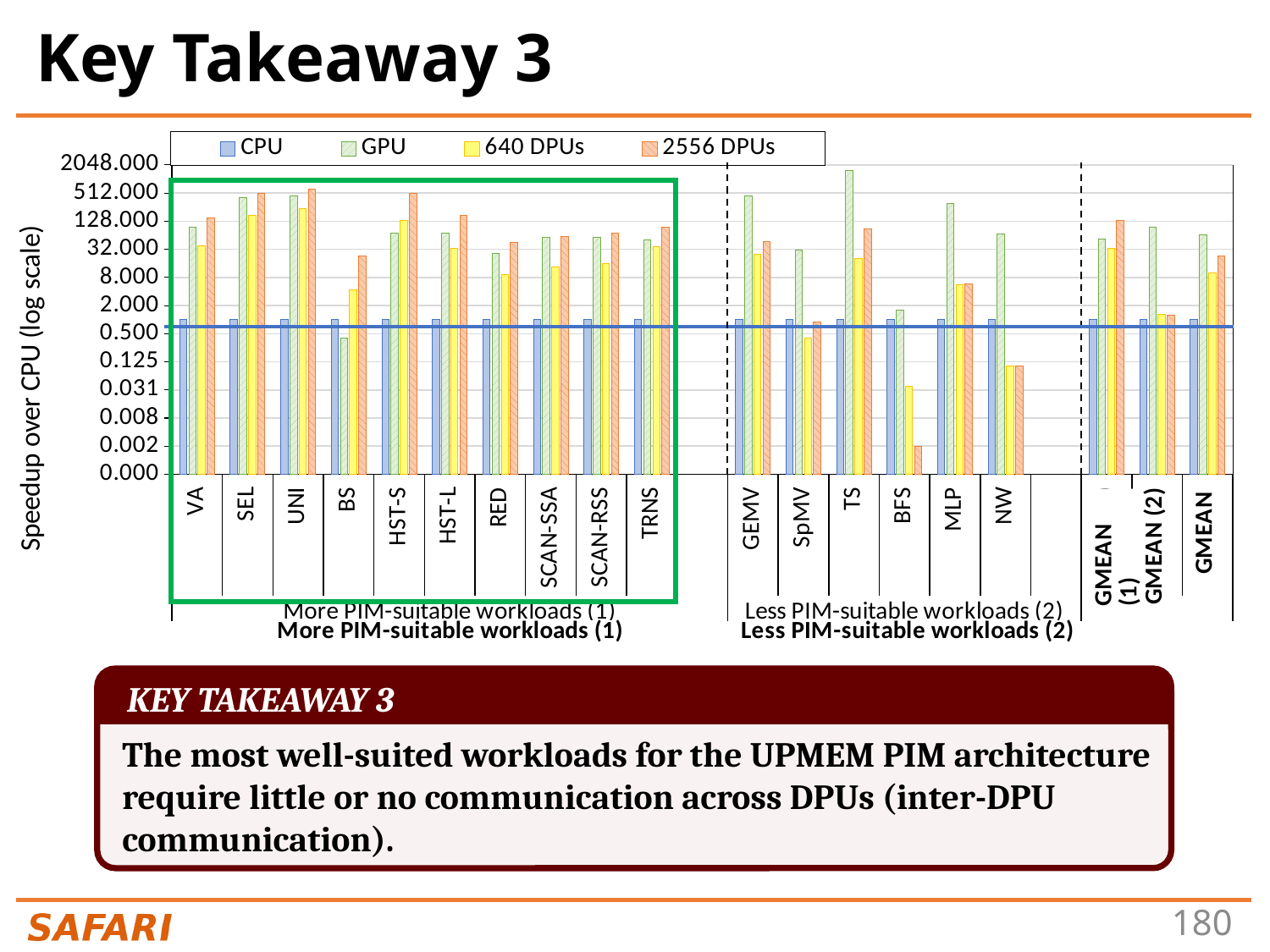
Is the GPU value for BS greater or less than 0.5? less What is the label of the y axis? Speedup over CPU (log scale) Which series has the highest bar for TS? GPU How many series does the legend list? 4 Is the 2556 DPUs value for BFS greater or less than 0.125? less Is the GPU value for GEMV greater or less than 128? greater For BS, which is larger: the GPU value or the 640 DPUs value? 640 DPUs What kind of chart is shown on the slide? bar chart Which workload has the highest GPU bar? TS For NW, which is larger: the GPU value or the 2556 DPUs value? GPU